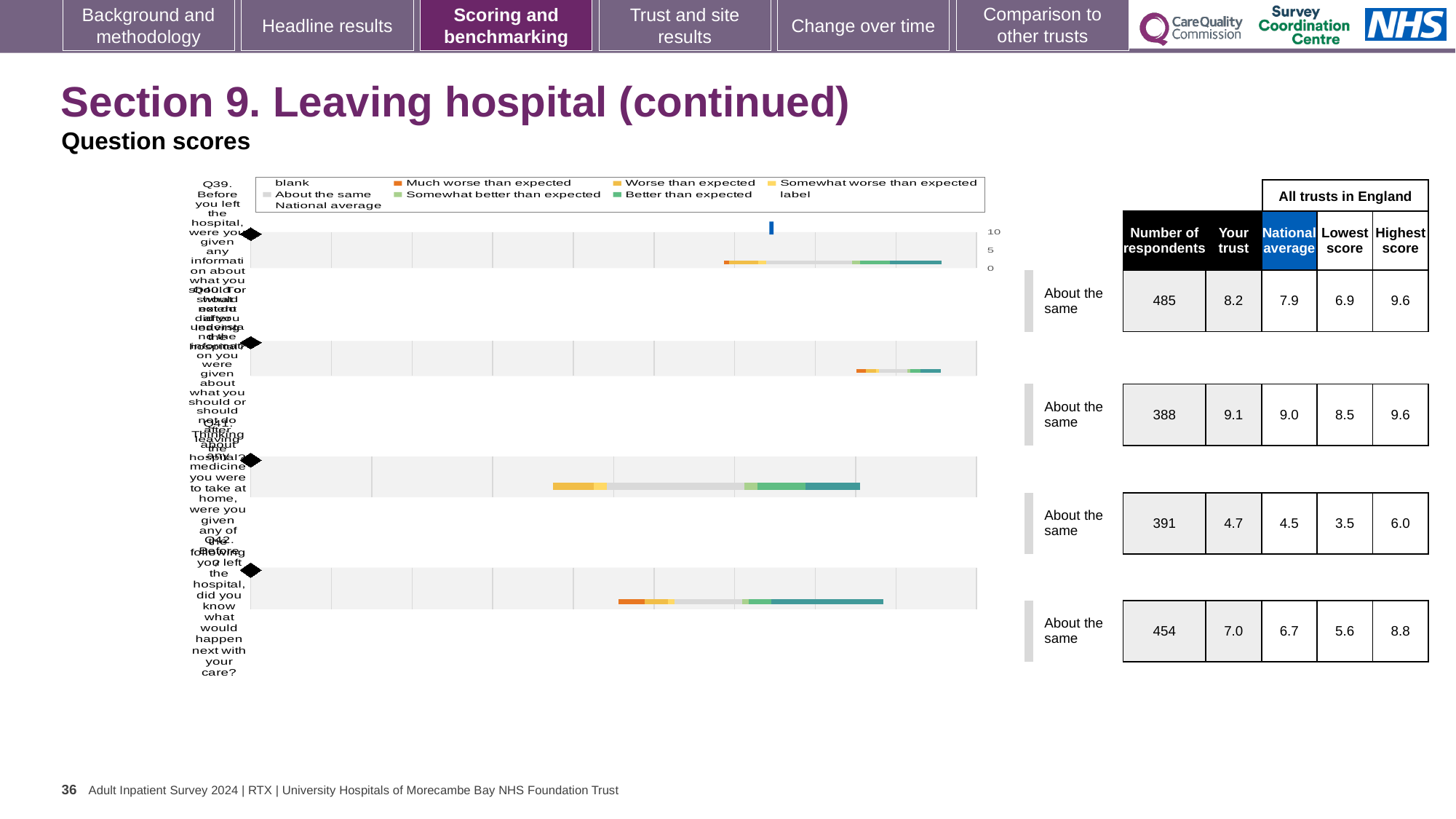
In the table beside the chart, what is the 'Your trust' score for the first row (Q39)? 8.2 What is the highest value shown on the chart's score axis? 10 In the table beside the chart, what is the number of respondents for the fourth row (Q42)? 454 What benchmark category is shown next to each of the four question bars? About the same What kind of chart is used to show the question scores on this slide? bar chart In the table beside the chart, which row has the lowest 'Your trust' score? Q41 (4.7) In the table beside the chart, what is the difference between the highest score and lowest score for the third row (Q41)? 2.5 In the table beside the chart, what is the national average for the second row (Q40)? 9.0 How many question bars are plotted in the chart? 4